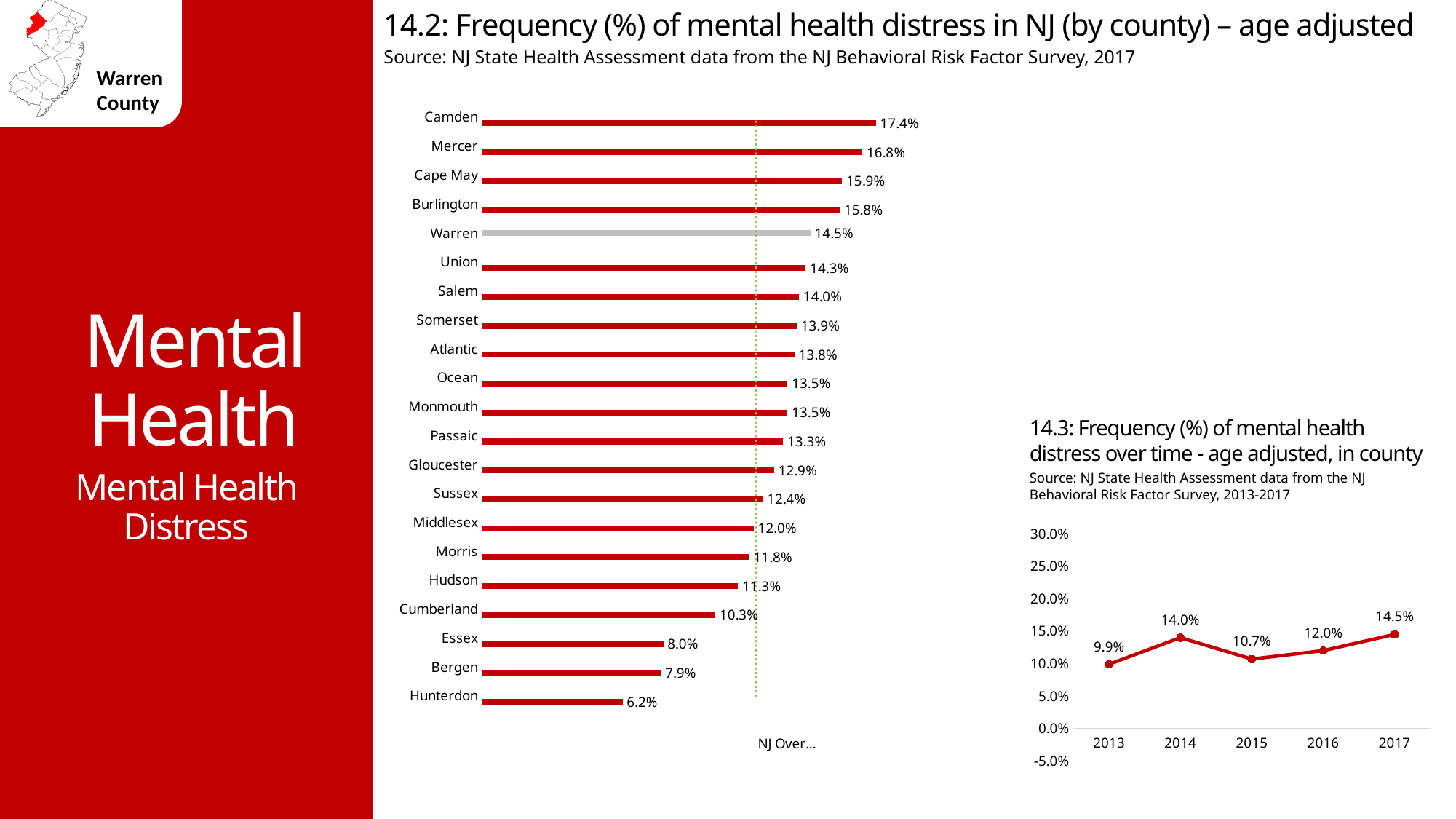
In chart 14.3 (mental health distress over time), what is the value for 2013? 9.9% In chart 14.2 (frequency of mental health distress by county), which county has the highest value? Camden In chart 14.2 (frequency of mental health distress by county), how many counties are shown? 21 In chart 14.2 (frequency of mental health distress by county), which is larger, Mercer or Cape May? Mercer In chart 14.2 (frequency of mental health distress by county), what is the value for Warren? 14.5% In chart 14.3 (mental health distress over time), what is the difference between 2014 and 2015? 3.3% What kind of chart is chart 14.3 (mental health distress over time)? Line chart In chart 14.2 (frequency of mental health distress by county), what is the difference between Camden and Hunterdon? 11.2% In chart 14.3 (mental health distress over time), which year has the highest value? 2017 What kind of chart is chart 14.2 (frequency of mental health distress by county)? Bar chart In chart 14.2 (frequency of mental health distress by county), which county has the lowest value? Hunterdon In chart 14.2 (frequency of mental health distress by county), what is the value for Cumberland? 10.3%